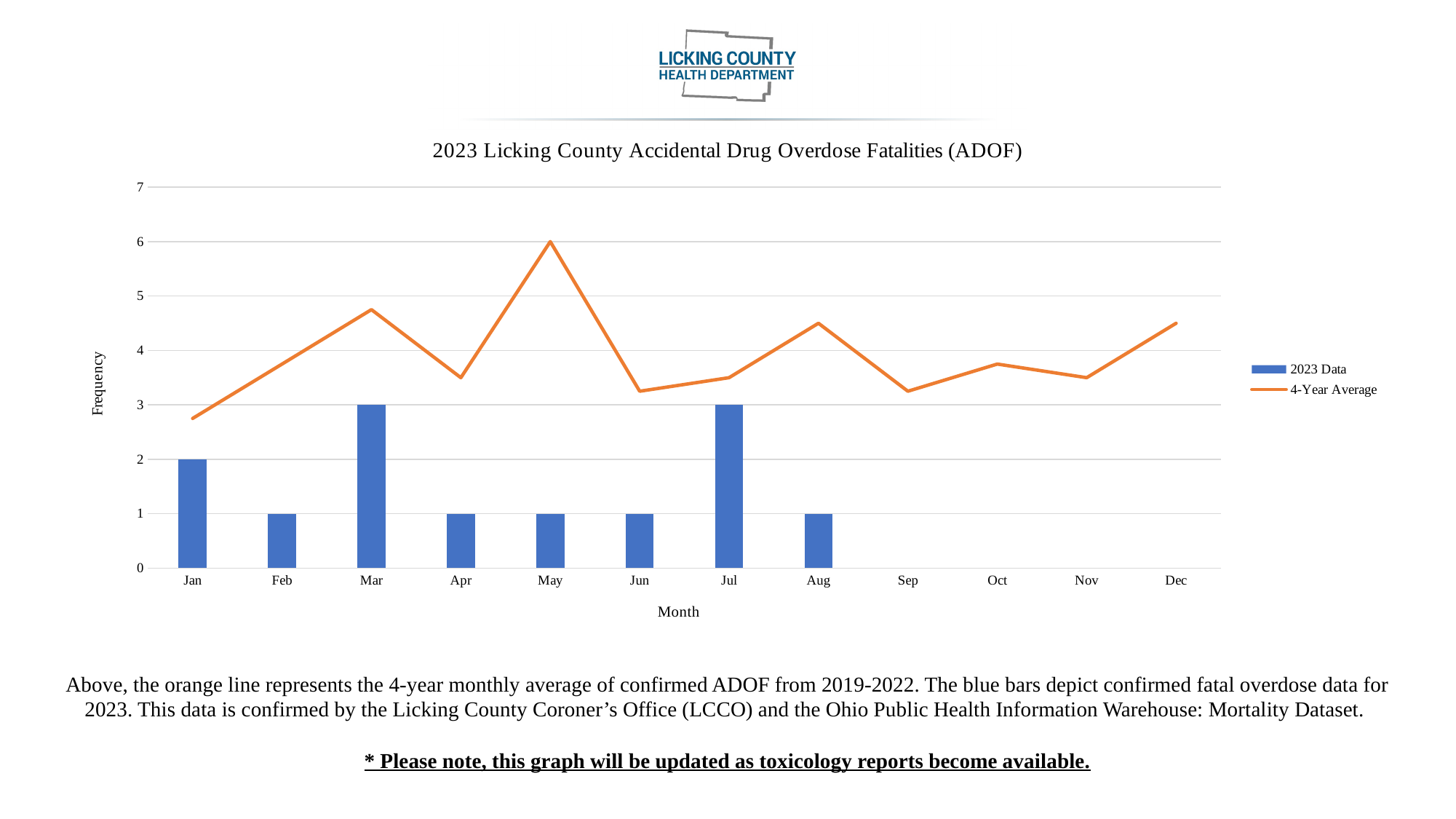
What is the title of the chart? 2023 Licking County Accidental Drug Overdose Fatalities (ADOF) How many series does the legend list? 2 Which is larger for 2023 Data, Jul or Feb? Jul What is the difference between the 2023 Data values for Mar and Feb? 2 How many months are shown on the x axis? 12 In which month is the 4-Year Average highest? May What is the 2023 Data value for Mar? 3 Is the 4-Year Average value for Jan greater or less than 3? less What kind of chart is this? Combined bar and line chart Is the 4-Year Average value for Mar greater or less than 4? greater What is the 2023 Data value for Jan? 2 What is the 4-Year Average value for May? 6